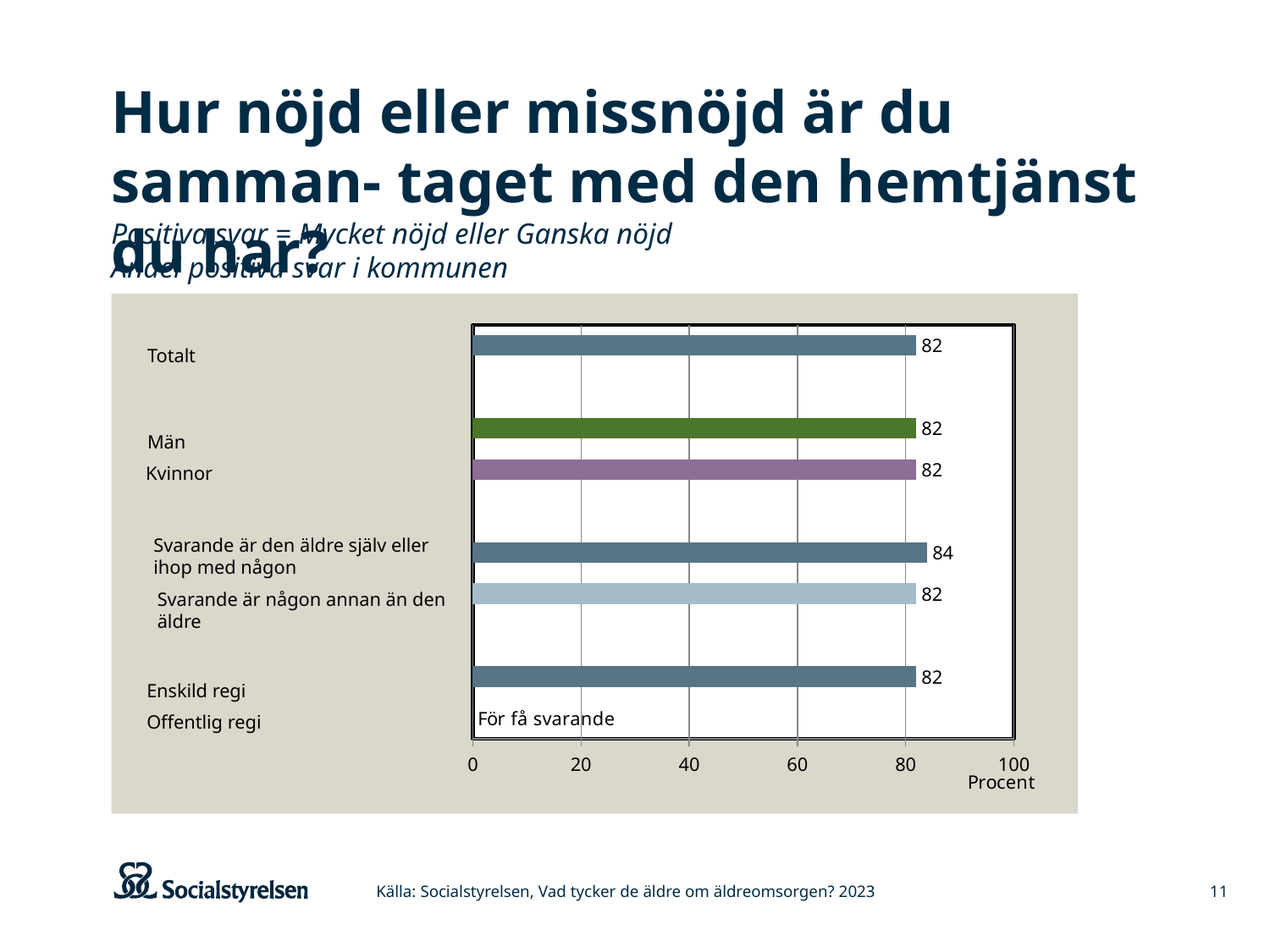
Is the value for Totalt greater or less than 60? greater What is the difference between the value for 'Svarande är den äldre själv eller ihop med någon' and the value for 'Svarande är någon annan än den äldre'? 2 What is the value for 'Svarande är den äldre själv eller ihop med någon'? 84 What is the label of the horizontal axis? Procent How many bars are plotted in the chart? 6 What is shown for Offentlig regi instead of a bar? För få svarande What is the value for Totalt? 82 What is the value for Män? 82 Which category has the highest value? Svarande är den äldre själv eller ihop med någon What kind of chart is shown on the slide? bar chart What is the value for Enskild regi? 82 What is the value for Kvinnor? 82